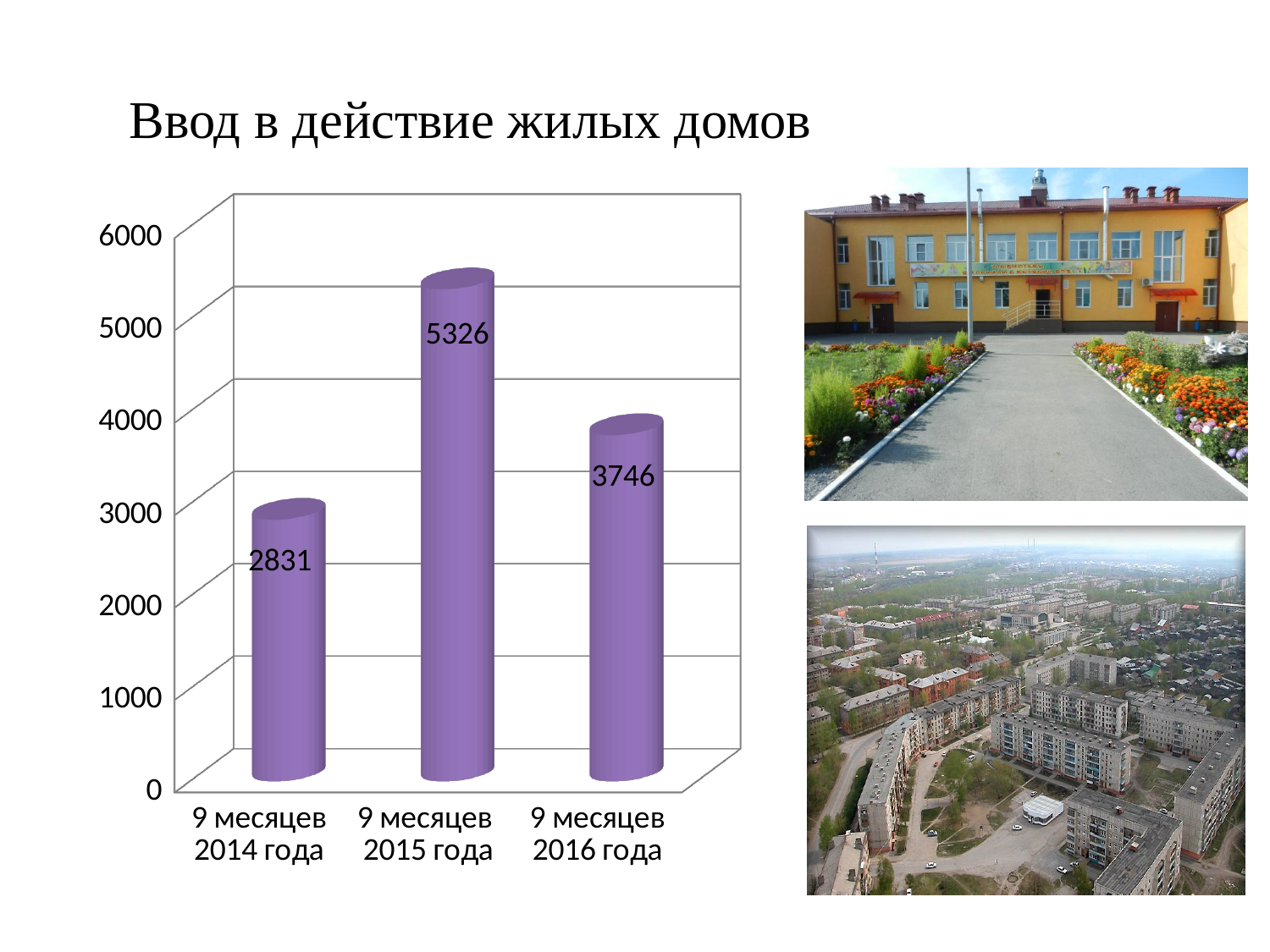
What kind of chart is shown on the slide? bar chart Which category has the highest value? 9 месяцев 2015 года Which is larger, the value for 9 месяцев 2016 года or 9 месяцев 2014 года? 9 месяцев 2016 года What is the difference between the values for 9 месяцев 2015 года and 9 месяцев 2014 года? 2495 Is the value for 9 месяцев 2015 года greater or less than 5000? greater Which category has the lowest value? 9 месяцев 2014 года What is the value for 9 месяцев 2014 года? 2831 What is the title of the slide above the chart? Ввод в действие жилых домов What is the value for 9 месяцев 2016 года? 3746 What is the value for 9 месяцев 2015 года? 5326 What is the difference between the values for 9 месяцев 2015 года and 9 месяцев 2016 года? 1580 How many categories are shown on the chart? 3